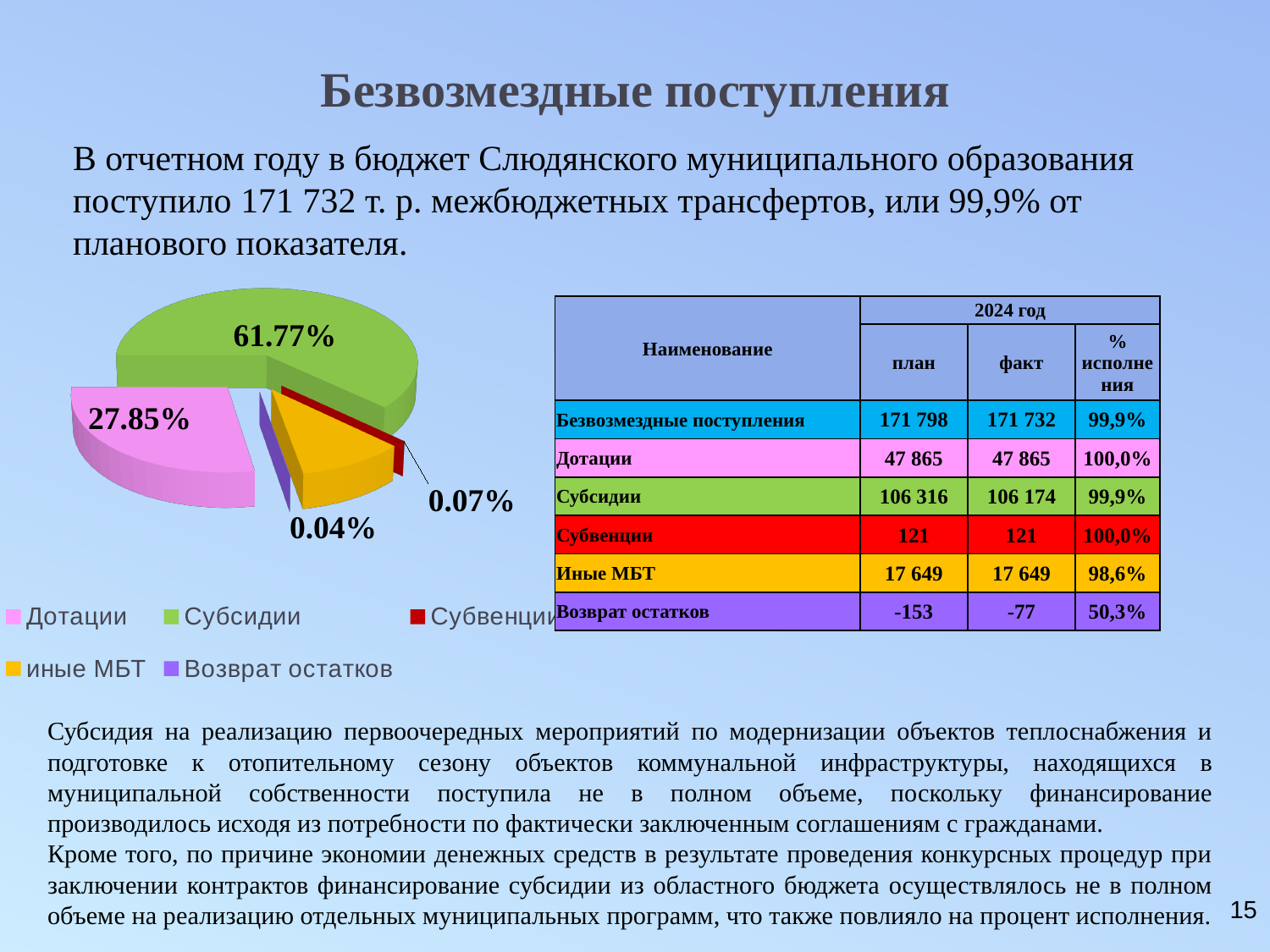
What colour is the Дотации slice in the pie chart? pink How many entries does the pie chart's legend list? 5 What share of the pie does the Дотации slice represent? 27.85% Which slice of the pie chart is the smallest? Возврат остатков What share of the pie does the Субвенции slice represent? 0.07% What is the difference between the Субсидии share and the Дотации share in the pie chart? 33.92% Which is larger in the pie chart, Дотации or Субсидии? Субсидии What share of the pie does the Возврат остатков slice represent? 0.04% What kind of chart is shown on the slide? pie chart What colour is the Субсидии slice in the pie chart? green Which slice of the pie chart is the largest? Субсидии